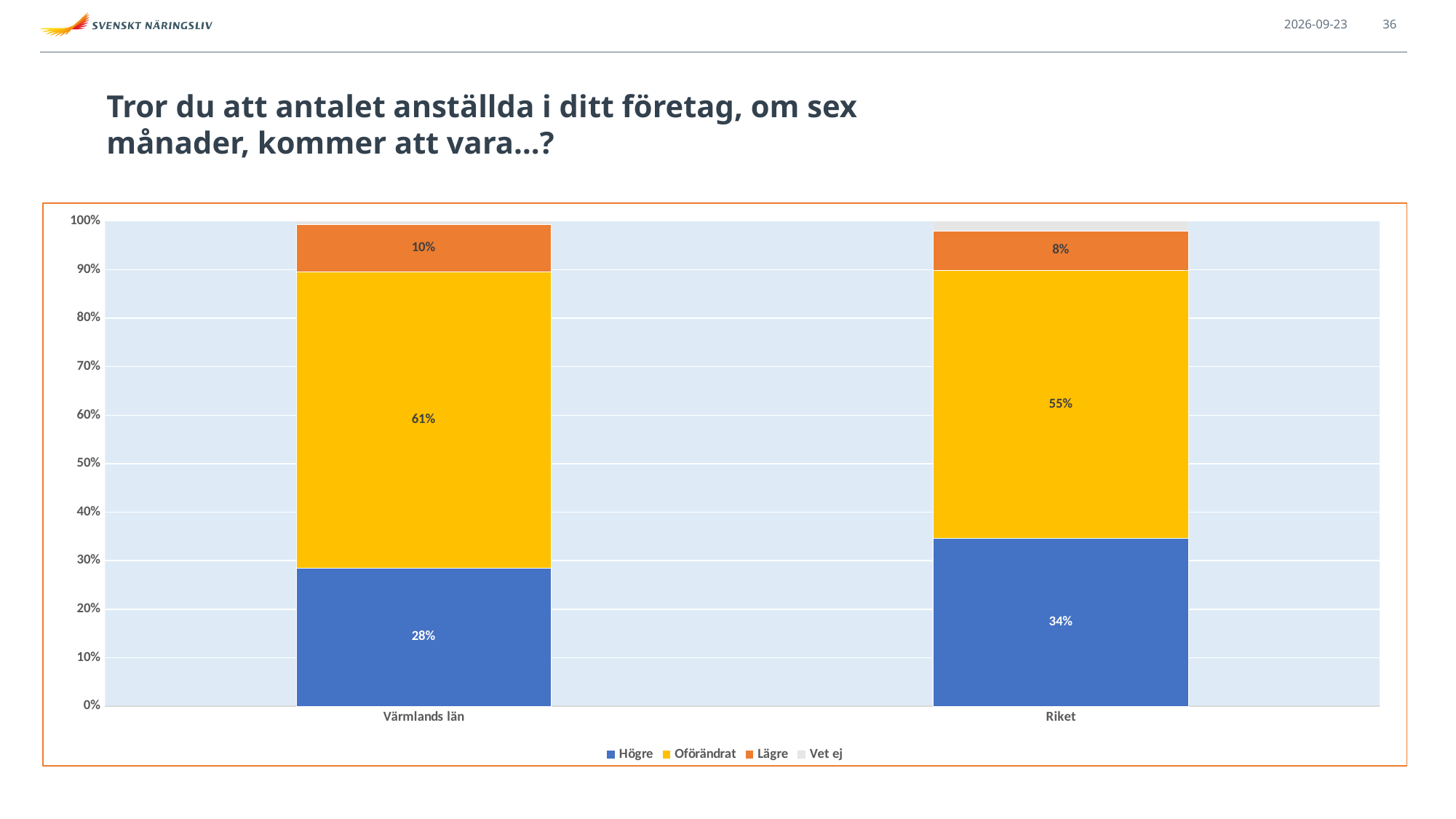
Which answer option has the largest share in Värmlands län? Oförändrat What is the difference between the Oförändrat values for Värmlands län and Riket? 6 percentage points Which category has the higher value for Högre, Värmlands län or Riket? Riket What is the value for Lägre in Värmlands län? 10% How many categories are shown on the x axis? 2 What kind of chart is shown on the slide? Stacked bar chart What is the value for Lägre in Riket? 8% What is the difference between the Högre values for Riket and Värmlands län? 6 percentage points What percentage of respondents in Värmlands län answered Högre? 28% What percentage of respondents in Riket answered Oförändrat? 55% How many series does the legend list? 4 Which category has the higher value for Oförändrat, Värmlands län or Riket? Värmlands län